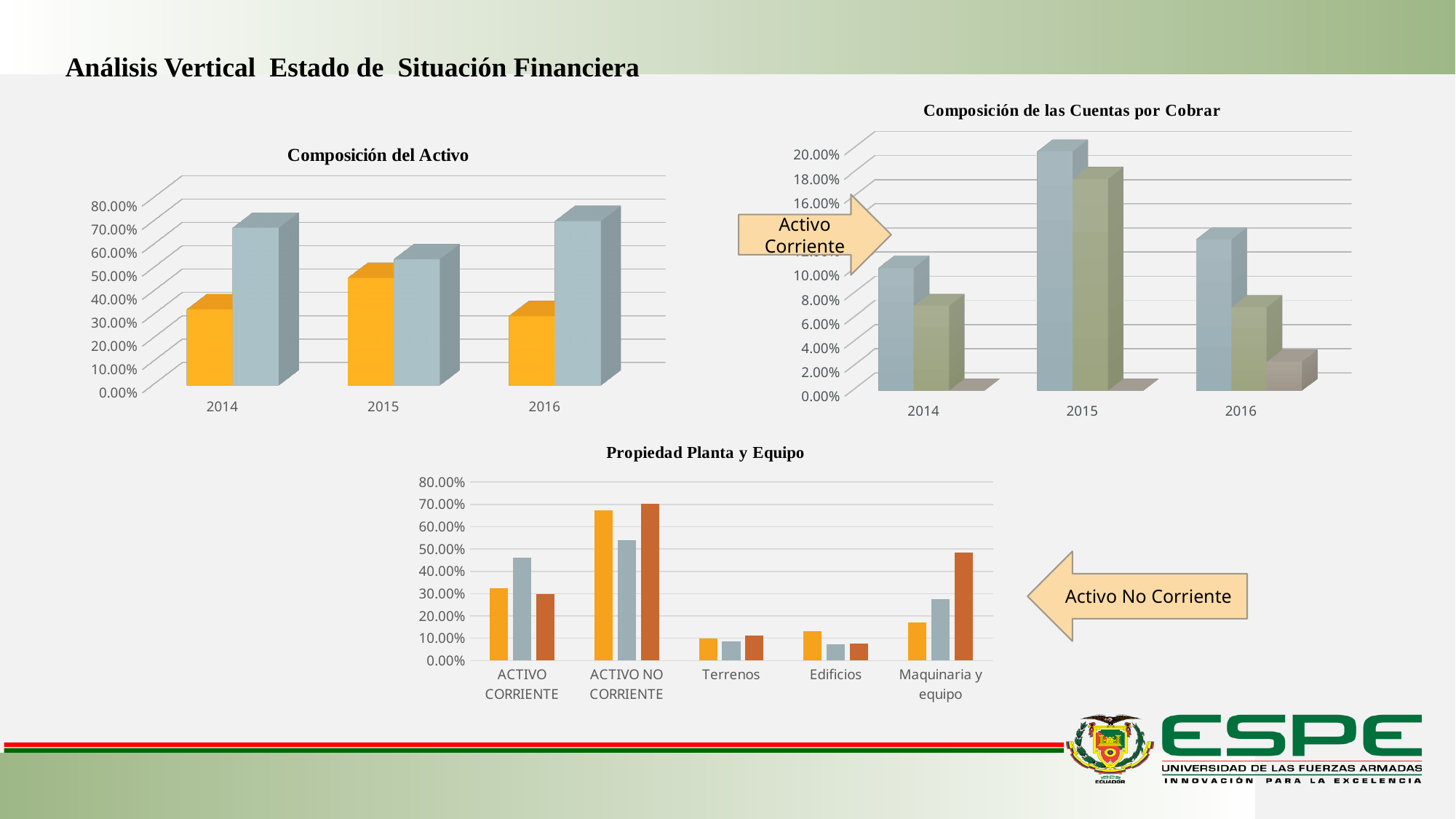
In the "Propiedad Planta y Equipo" chart, which category has the tallest bar? ACTIVO NO CORRIENTE In the "Composición de las Cuentas por Cobrar" chart, is the tallest bar for 2015 greater or less than 16.00%? greater In the "Composición de las Cuentas por Cobrar" chart, which year has the tallest bar? 2015 How many years are shown on the x axis of the "Composición del Activo" chart? 3 In the "Composición del Activo" chart, is the orange bar for 2015 greater or less than 40.00%? greater What is the title of the chart in the top-left of the slide? Composición del Activo What kind of chart is "Propiedad Planta y Equipo"? Bar chart How many categories are shown on the x axis of the "Propiedad Planta y Equipo" chart? 5 In the "Propiedad Planta y Equipo" chart, is the grey bar for Maquinaria y equipo greater or less than 20.00%? greater In the "Propiedad Planta y Equipo" chart, for Maquinaria y equipo, which is larger: the orange bar or the dark orange bar? The dark orange bar In the "Composición del Activo" chart, for 2014, which is larger: the orange bar or the grey-blue bar? The grey-blue bar